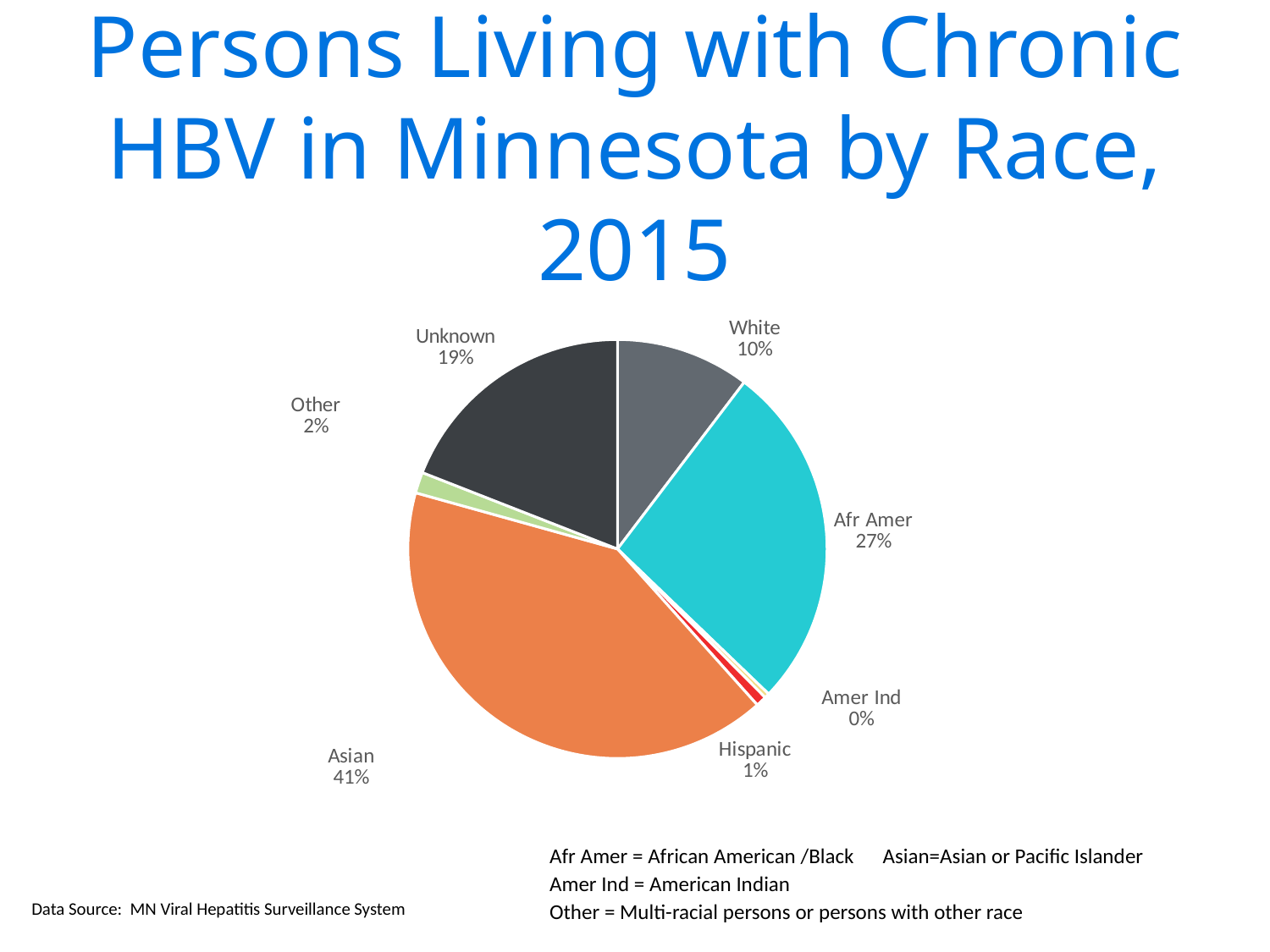
Which race category has the largest share of the pie? Asian How many race categories are labelled on the pie chart? 7 What share of persons living with chronic HBV in Minnesota in 2015 is Asian? 41% What percentage is shown for White? 10% What percentage of the pie is labelled Afr Amer? 27% What type of chart is shown on the slide? Pie chart Which is larger, the Unknown share or the White share? Unknown What share is shown for the Unknown category? 19% What percentage is shown for Hispanic? 1% Which category has the smallest share shown on the pie? Amer Ind What is the difference in percentage points between the Asian and Afr Amer shares? 14 What is the title of the chart? Persons Living with Chronic HBV in Minnesota by Race, 2015